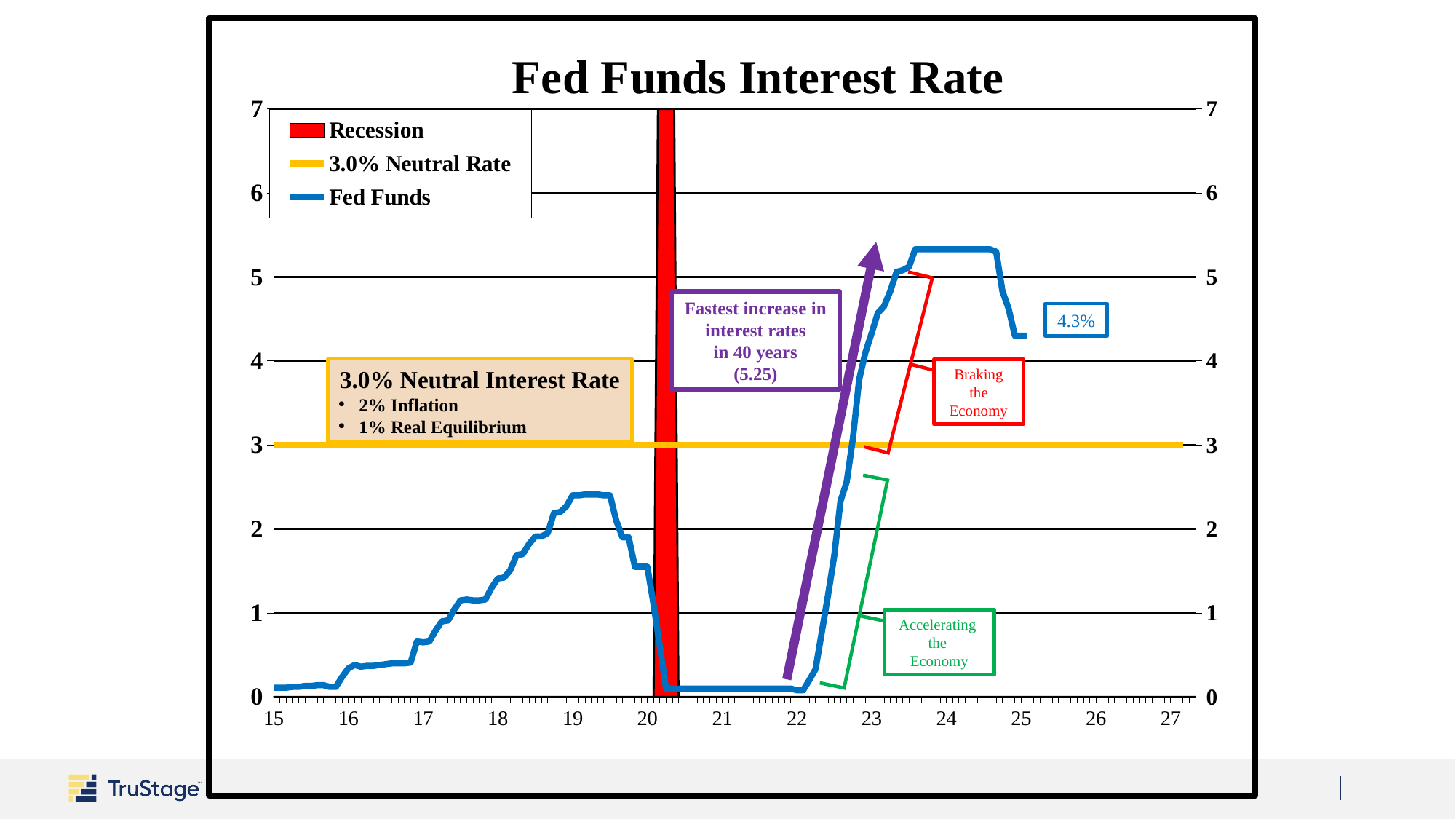
Is the Fed Funds value at its 2019 peak greater or less than 2? greater Is the Fed Funds value in 2024 greater or less than 5? greater Does the Fed Funds line rise or fall between 2024 and 2025? fall Is the Fed Funds value in 2021 greater or less than 1? less What is the title of the chart? Fed Funds Interest Rate What value is labelled at the end of the Fed Funds line, around 2025? 4.3% What value is given in the annotation for the fastest increase in interest rates in 40 years? 5.25 What level is the neutral rate line drawn at, according to the legend? 3.0% Does the Fed Funds line rise or fall between 2022 and 2023? rise How many entries does the chart legend list? 3 What kind of chart is shown on the slide? line chart Which is higher on the Fed Funds line: the 2019 peak or the 2024 level? 2024